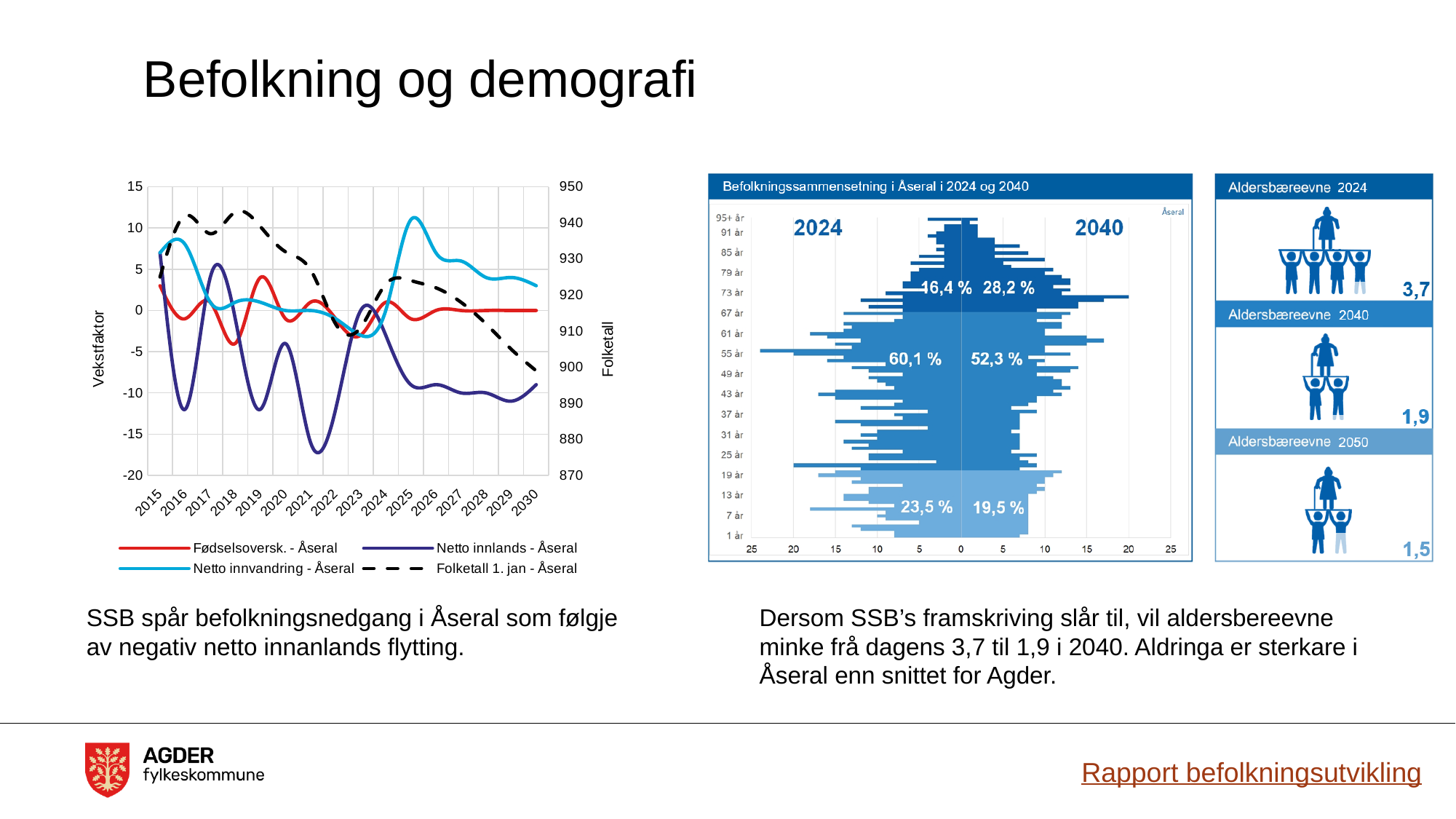
In the chart 'Befolkningssammensetning i Åseral i 2024 og 2040', what is the difference between the oldest age group's share in 2040 and in 2024? 11,8 % What kind of chart is the chart on the left of the slide with the Vekstfaktor axis? line chart In the chart 'Befolkningssammensetning i Åseral i 2024 og 2040', what share is shown for the youngest age group in 2024? 23,5 % How many series does the legend of the left line chart list? 4 In the chart 'Befolkningssammensetning i Åseral i 2024 og 2040', what share is shown for the oldest age group in 2040? 28,2 % In the left line chart, does the Folketall 1. jan - Åseral line rise or fall from 2024 to 2030? fall In the left line chart, which series is drawn as a dashed black line? Folketall 1. jan - Åseral In the left line chart, is the Folketall 1. jan - Åseral value in 2022 greater or less than 920? less In the left line chart, is the value for Netto innvandring - Åseral in 2025 greater or less than 10? greater In the Aldersbæreevne panels on the right, which year has the lowest value? 2050 In the left line chart, is the value for Netto innlands - Åseral in 2016 greater or less than -10? less In the chart 'Befolkningssammensetning i Åseral i 2024 og 2040', is the share of the middle age group larger in 2024 or in 2040? 2024